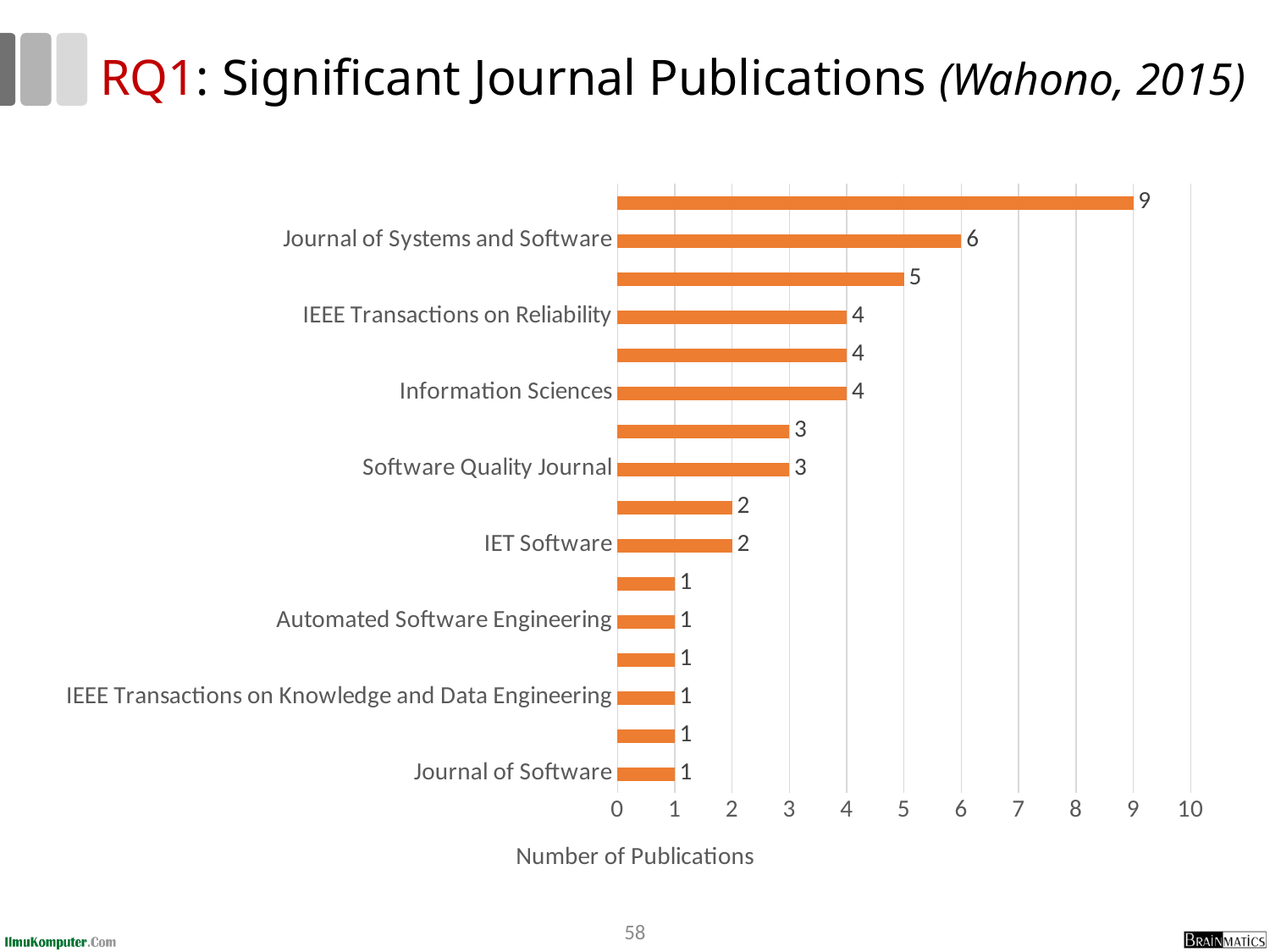
What is the number of publications for Journal of Software? 1 Which has more publications, IEEE Transactions on Reliability or IET Software? IEEE Transactions on Reliability What is the number of publications for IEEE Transactions on Reliability? 4 What is the number of publications for IET Software? 2 What is the highest value shown on any bar in the chart? 9 What is the number of publications for Information Sciences? 4 What is the number of publications for Journal of Systems and Software? 6 What is the number of publications for Software Quality Journal? 3 What is the label of the horizontal axis? Number of Publications What is the difference in number of publications between Journal of Systems and Software and Software Quality Journal? 3 How many bars are plotted in the chart? 16 What type of chart is shown on the slide? Bar chart